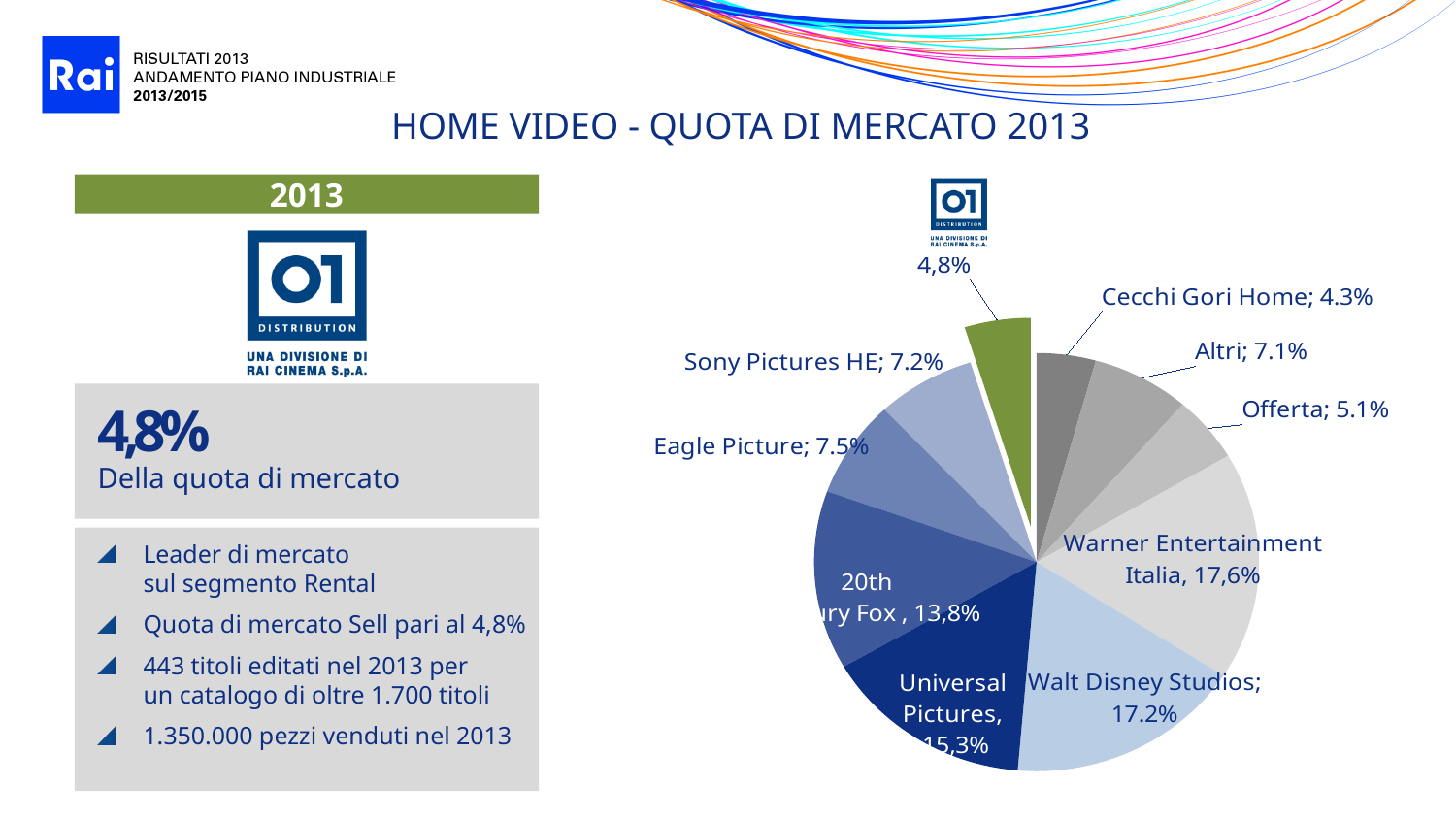
What is the market share shown for Eagle Picture? 7.5% What is the market share shown for Cecchi Gori Home? 4.3% What is the difference in percentage points between Altri and Offerta? 2.0 Which has a larger share, Sony Pictures HE or Eagle Picture? Eagle Picture Which slice of the pie chart has the smallest share? Cecchi Gori Home What is the market share shown for Warner Entertainment Italia? 17,6% What type of chart is shown on the slide? Pie chart What is the title of the slide containing the pie chart? HOME VIDEO - QUOTA DI MERCATO 2013 What is the market share shown for Walt Disney Studios? 17.2% Which slice of the pie chart has the largest share? Warner Entertainment Italia How many slices does the pie chart have? 10 What is the market share shown for Universal Pictures? 15,3%